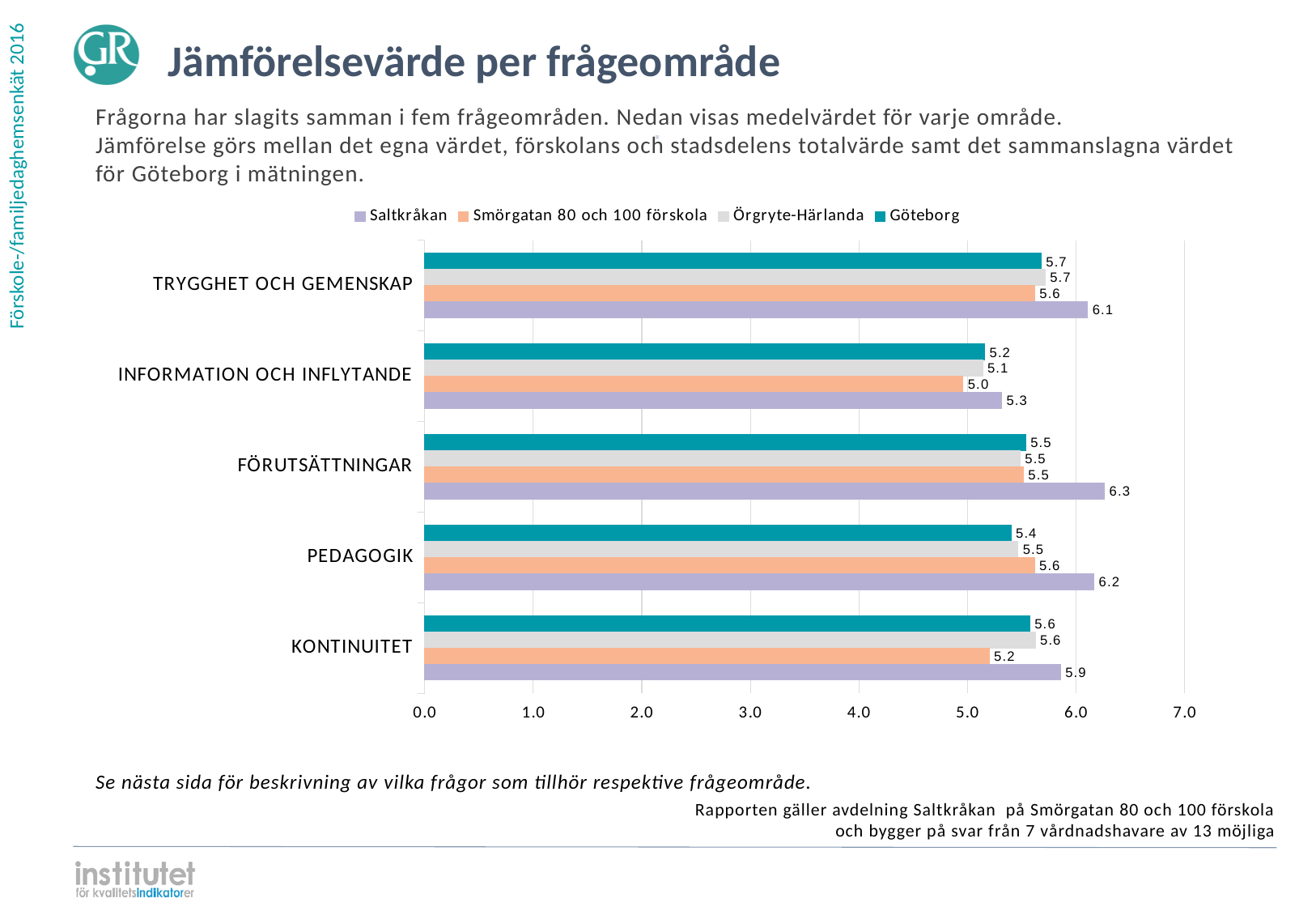
In which question area does Saltkråkan have its lowest value? INFORMATION OCH INFLYTANDE In which question area does Saltkråkan have its highest value? FÖRUTSÄTTNINGAR What is the value for Örgryte-Härlanda in INFORMATION OCH INFLYTANDE? 5.1 What is the difference between Saltkråkan and Göteborg in PEDAGOGIK? 0.8 How many question areas (categories) are shown on the chart? 5 Which is larger in KONTINUITET: Saltkråkan or Smörgatan 80 och 100 förskola? Saltkråkan What is the value for Saltkråkan in FÖRUTSÄTTNINGAR? 6.3 What kind of chart is shown on the slide? bar chart Which series is shown in teal in the legend? Göteborg What is the value for Smörgatan 80 och 100 förskola in KONTINUITET? 5.2 How many series does the legend list? 4 What is the value for Göteborg in PEDAGOGIK? 5.4